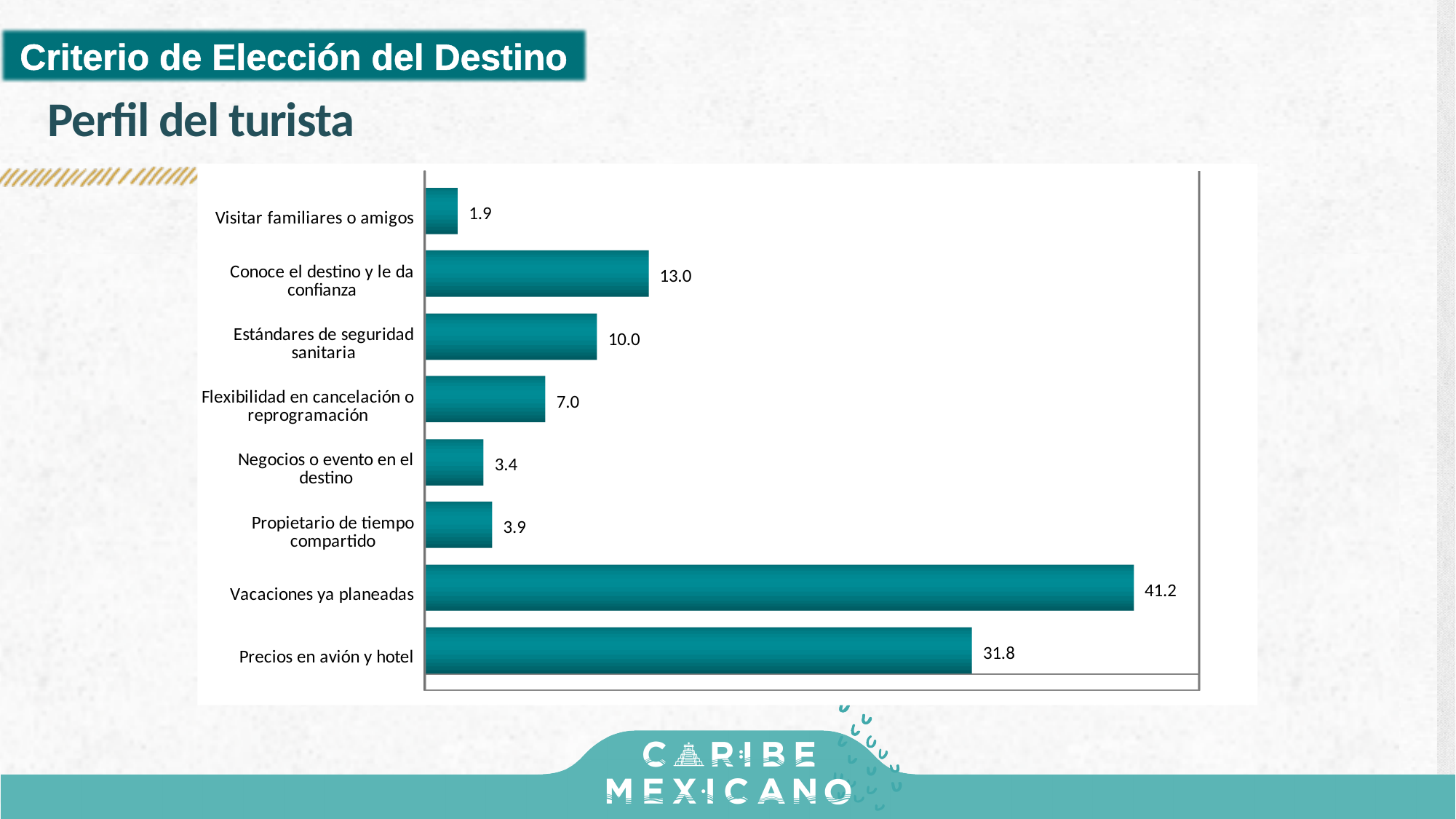
What colour are the bars in the chart? Teal What is the value for "Estándares de seguridad sanitaria"? 10.0 What is the value for "Vacaciones ya planeadas"? 41.2 What is the value for "Precios en avión y hotel"? 31.8 What is the difference between "Conoce el destino y le da confianza" and "Flexibilidad en cancelación o reprogramación"? 6.0 What kind of chart is shown on the slide? Bar chart Which category has the highest value? Vacaciones ya planeadas Which is larger, "Negocios o evento en el destino" or "Propietario de tiempo compartido"? Propietario de tiempo compartido Which category has the lowest value? Visitar familiares o amigos How many categories are shown in the chart? 8 What is the difference between "Vacaciones ya planeadas" and "Precios en avión y hotel"? 9.4 What is the value for "Visitar familiares o amigos"? 1.9